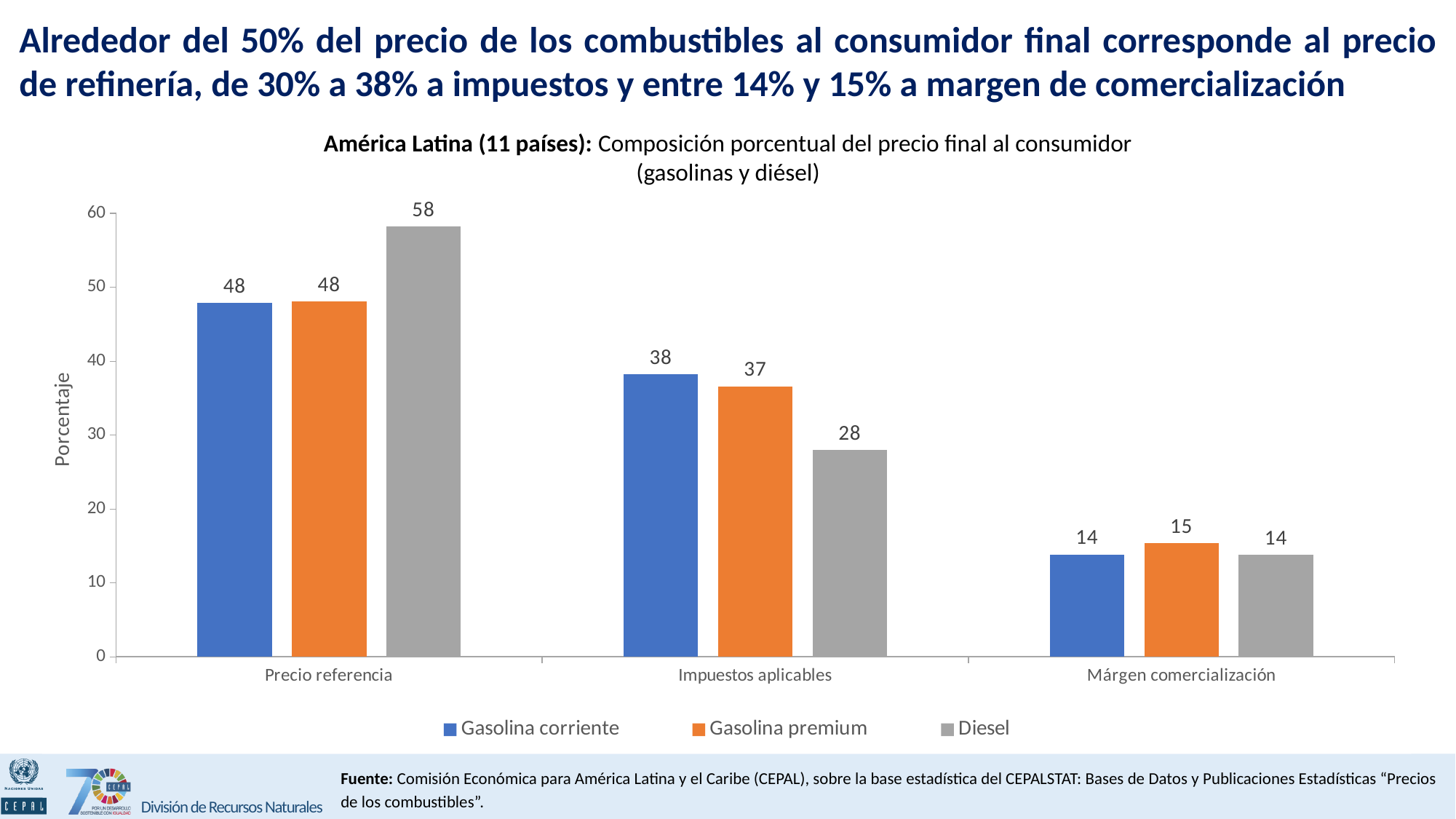
Which series has the lowest value in the Impuestos aplicables category? Diesel How many categories are shown on the x axis? 3 What is the difference between the Diesel value and the Gasolina corriente value in the Precio referencia category? 10 What is the label of the y axis? Porcentaje What kind of chart is shown on the slide? Bar chart Which series has the highest value in the Precio referencia category? Diesel What is the value for Gasolina corriente in the Márgen comercialización category? 14 What is the value for Diesel in the Precio referencia category? 58 What is the value for Gasolina premium in the Impuestos aplicables category? 37 How many series does the legend list? 3 Which is larger: the Gasolina corriente value for Impuestos aplicables or the Diesel value for Impuestos aplicables? Gasolina corriente What is the difference between the Gasolina corriente value and the Diesel value in the Impuestos aplicables category? 10